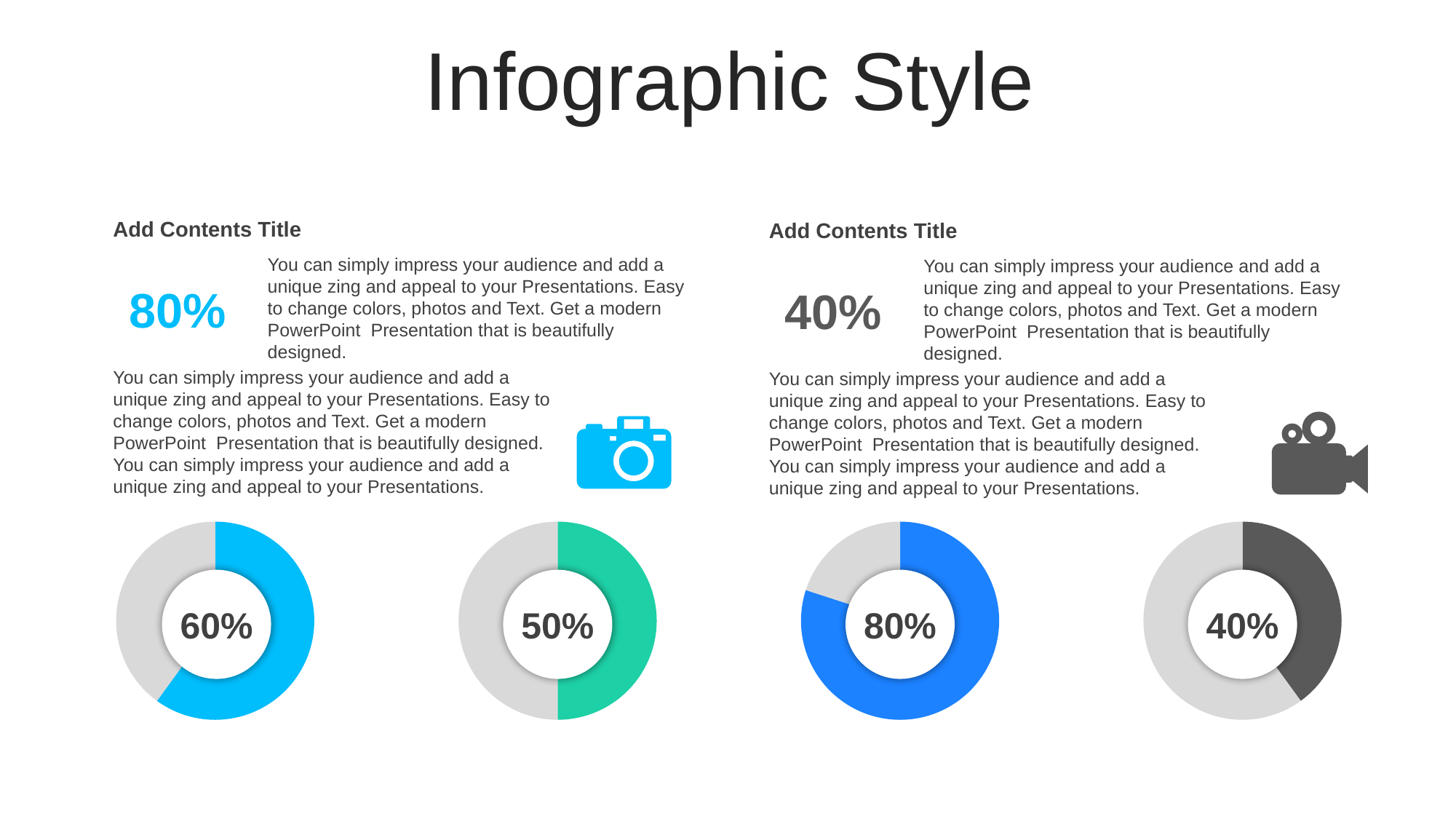
Which is larger: the value in the leftmost donut chart or the value in the second donut chart from the left? The leftmost (60%) What value is shown in the center of the third donut chart from the left? 80% What colour is the filled portion of the third donut chart from the left? Blue What value is shown in the center of the leftmost donut chart? 60% What value is shown in the center of the second donut chart from the left? 50% What kind of chart is used to display the percentages at the bottom of the slide? Donut chart What is the difference between the value in the third donut chart (80%) and the value in the rightmost donut chart (40%)? 40% What colour is the filled portion of the second donut chart from the left? Green What value is shown in the center of the rightmost donut chart? 40% How many donut charts are on the slide? 4 Which donut chart shows the highest percentage? The third from the left (80%) Which donut chart shows the lowest percentage? The rightmost (40%)